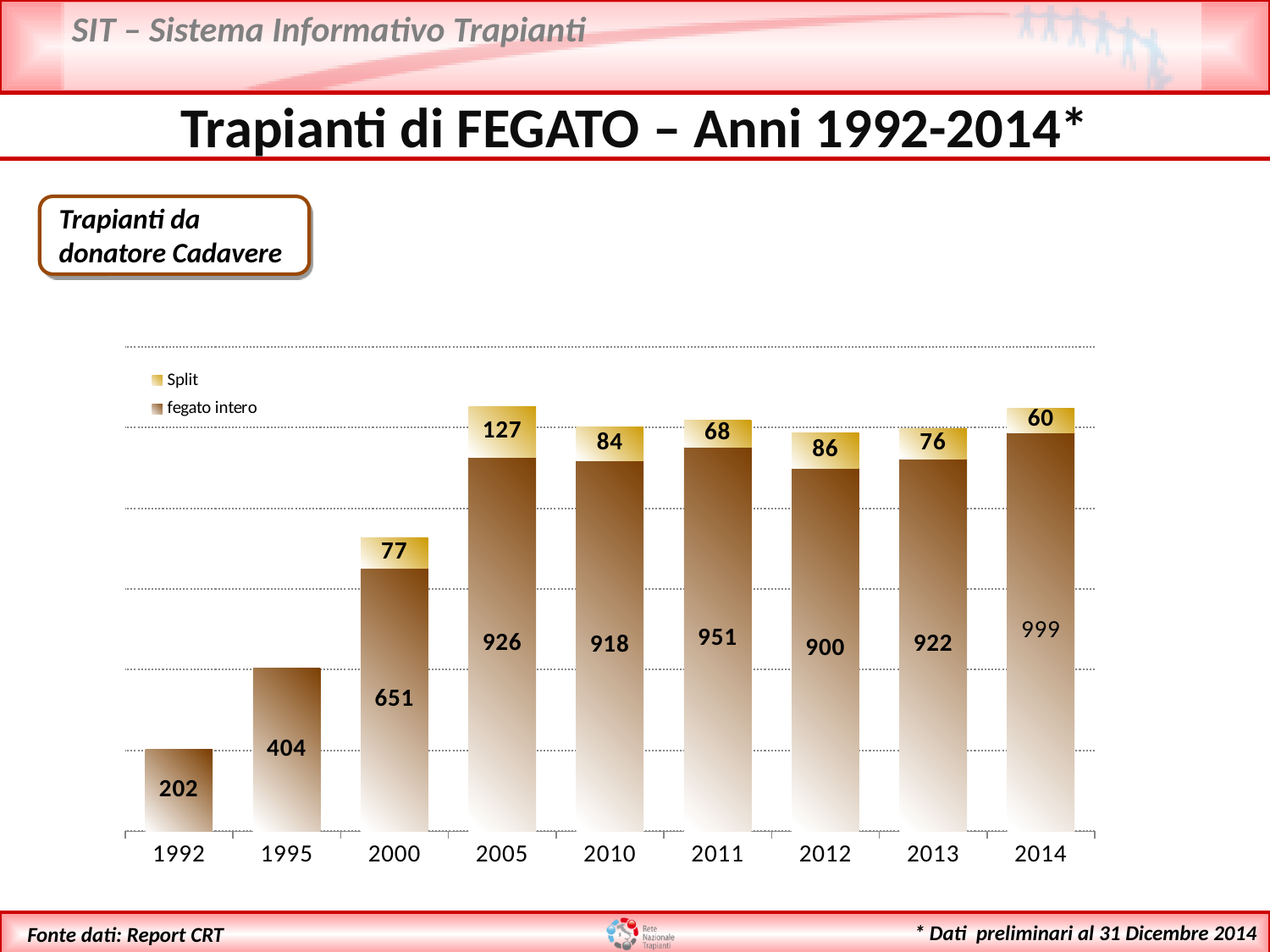
What is the value for fegato intero in 1992? 202 Which is larger, the Split value for 2010 or for 2013? 2010 Which year has the highest Split value? 2005 What kind of chart is shown on the slide? stacked bar chart What is the difference between the fegato intero values for 2011 and 2012? 51 What are the two legend entries of the chart? Split and fegato intero How many series does the legend list? 2 What is the value for fegato intero in 2014? 999 What is the total of the stacked bar for 2000? 728 What is the Split value for 2005? 127 How many years are shown on the x axis? 9 Which year has the lowest fegato intero value? 1992